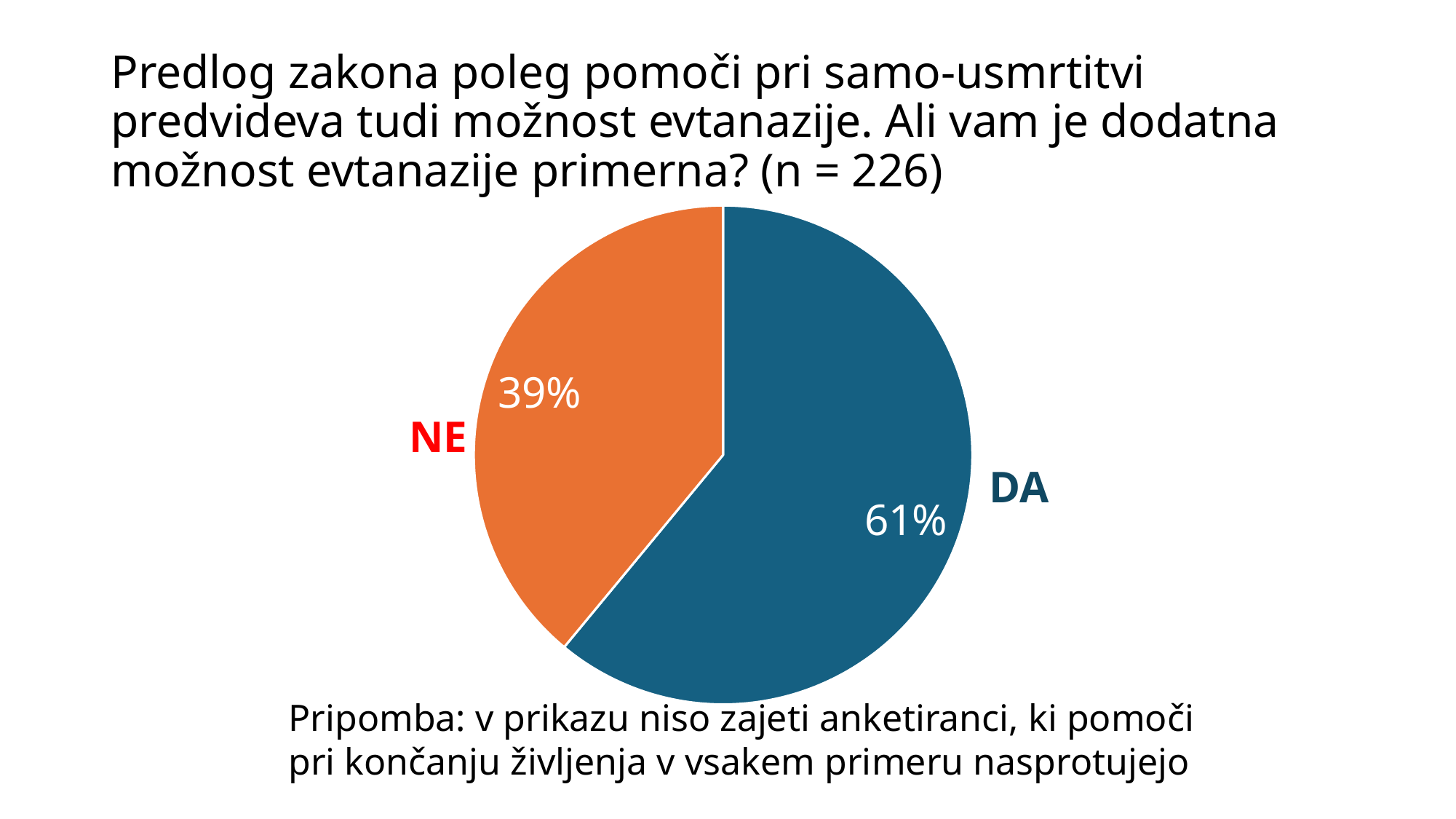
How many slices does the pie chart have? 2 Which answer has the largest share of the pie? DA What percentage of respondents answered DA? 61% What is the sample size (n) stated in the chart title? 226 What is the difference in percentage points between the DA and NE slices? 22 What colour is the NE slice? orange What share of the pie does the DA slice represent? 61% Which slice is larger, DA or NE? DA What percentage of respondents answered NE? 39% Which answer has the smallest share of the pie? NE What kind of chart is shown on the slide? pie chart